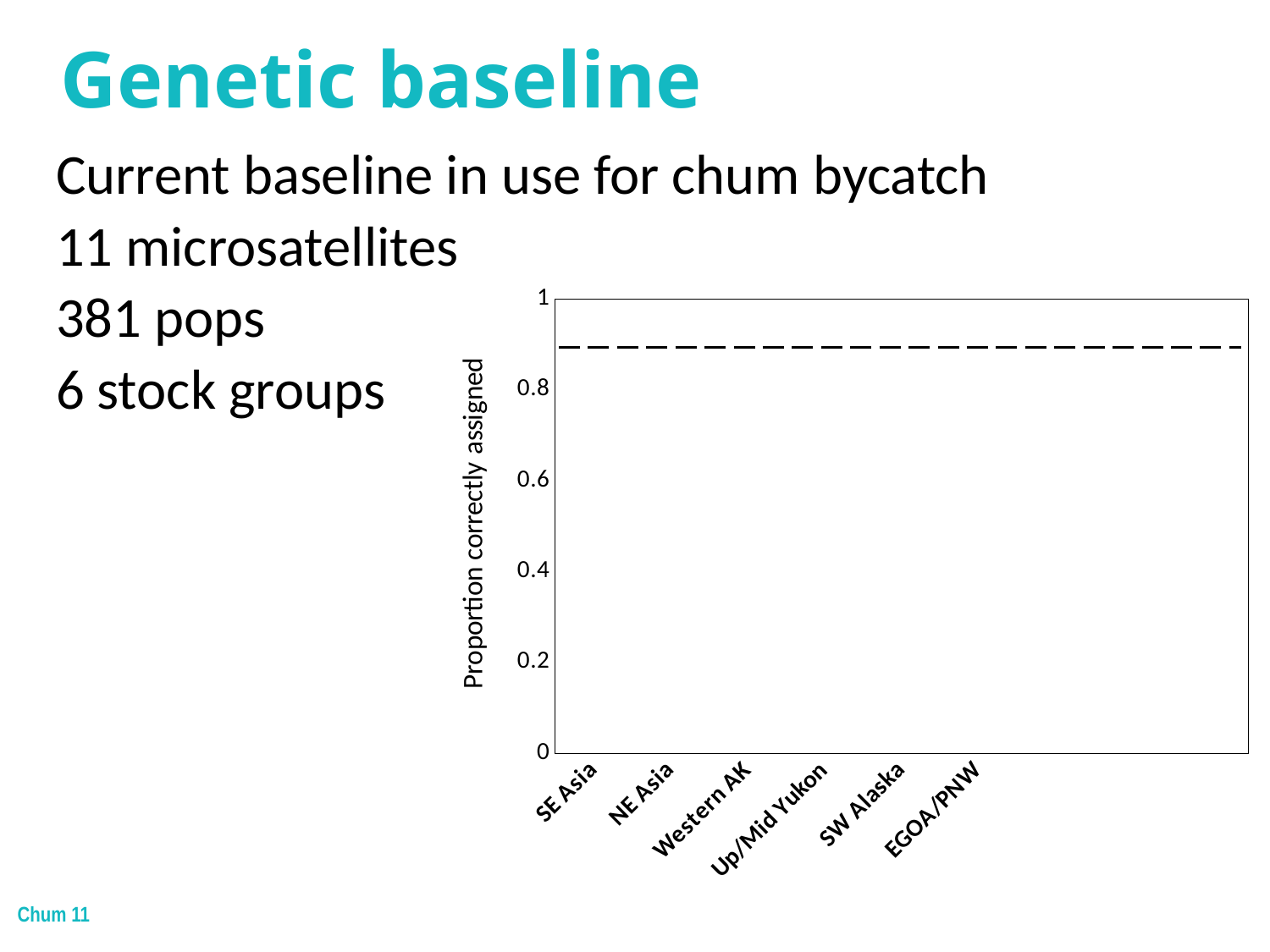
What is the highest tick value shown on the y axis of the chart? 1 Is the dashed horizontal line on the chart greater or less than 0.8? greater How many tick marks are labelled on the y axis of the chart? 6 Is the dashed horizontal line on the chart greater or less than 1? less What is the label on the y axis of the chart? Proportion correctly assigned How many categories are shown on the x axis of the chart? 6